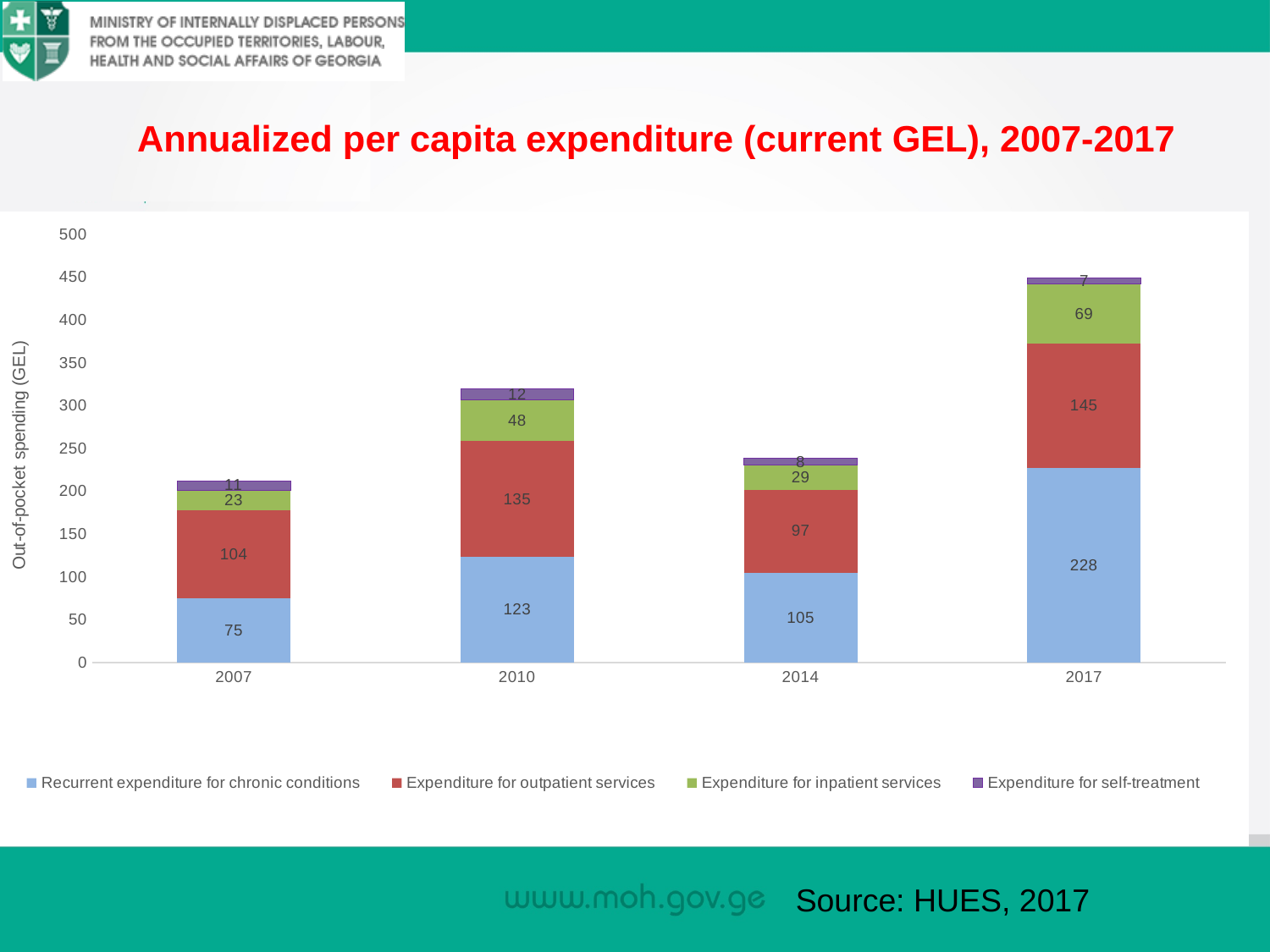
What is the expenditure for outpatient services in 2010? 135 Is the expenditure for outpatient services larger in 2010 or in 2014? 2010 Which year has the highest recurrent expenditure for chronic conditions? 2017 What type of chart is shown on the slide? Stacked bar chart What is the expenditure for inpatient services in 2014? 29 How many years are shown on the x axis? 4 What is the recurrent expenditure for chronic conditions in 2017? 228 What is the difference between expenditure for outpatient services in 2017 and in 2014? 48 How many series does the legend list? 4 Which year has the lowest expenditure for inpatient services? 2007 What is the expenditure for self-treatment in 2007? 11 What is the total out-of-pocket spending for the 2017 bar? 449